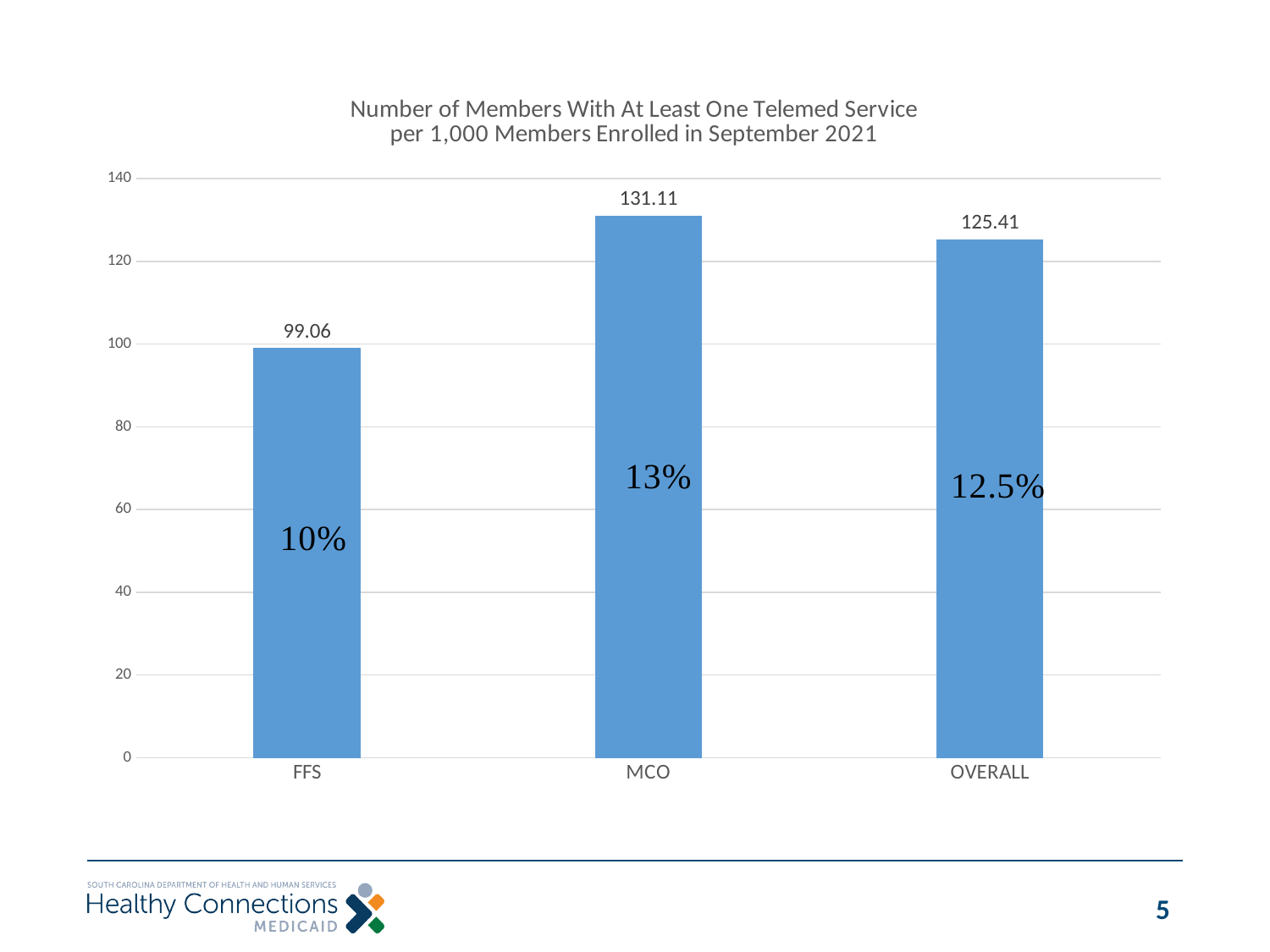
What percentage label is printed inside the MCO bar? 13% How many categories are shown on the x axis? 3 What is the difference between the MCO and OVERALL values? 5.7 Which is larger, the value for OVERALL or the value for FFS? OVERALL What is the value for FFS? 99.06 What is the value for OVERALL? 125.41 What is the difference between the MCO and FFS values? 32.05 Is the value for FFS greater or less than 100? less Which category has the lowest value? FFS What kind of chart is shown on the slide? bar chart Which category has the highest value? MCO What is the value for MCO? 131.11